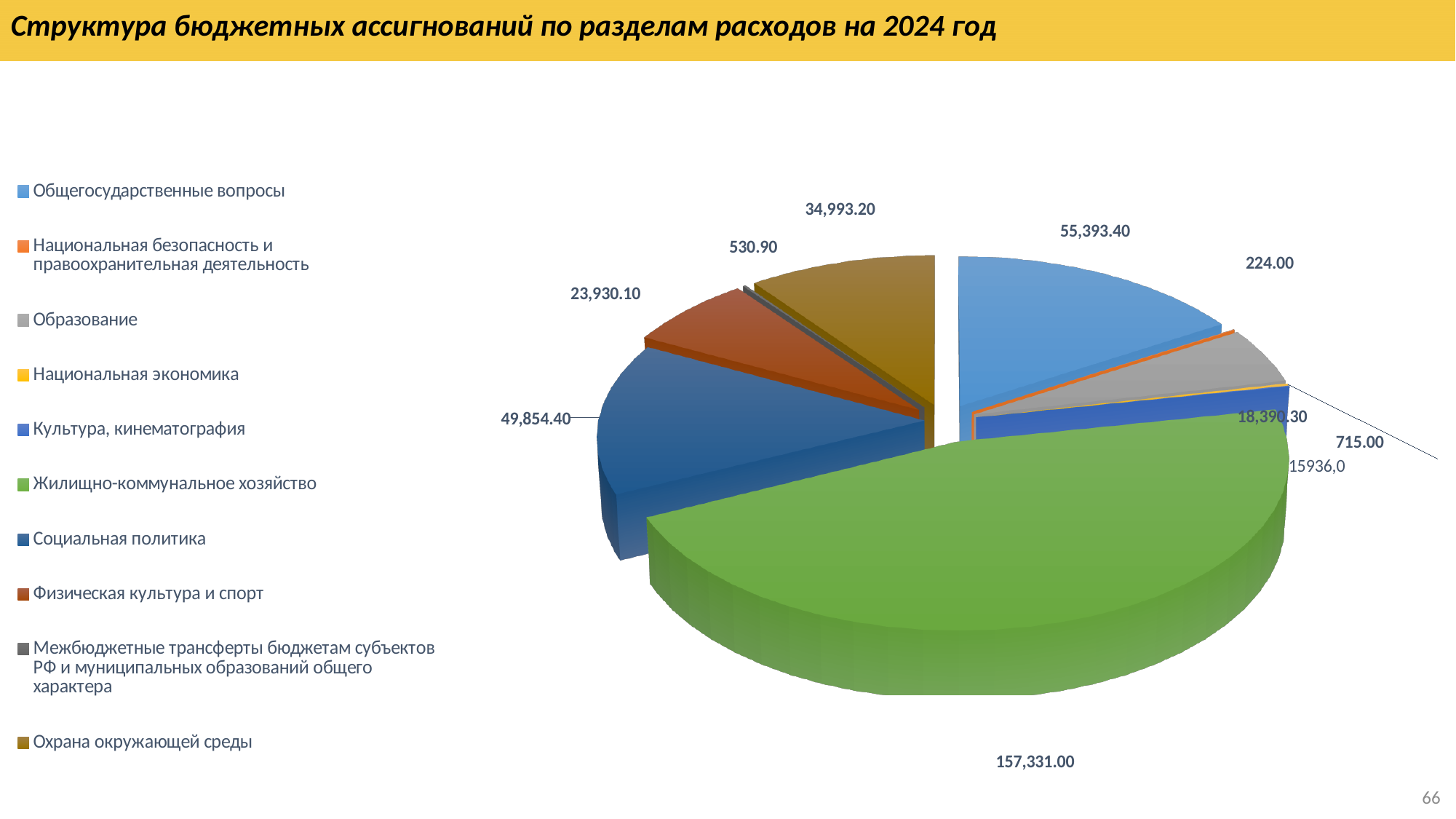
Which category has the smallest value in the pie chart? Национальная безопасность и правоохранительная деятельность What is the value shown for Жилищно-коммунальное хозяйство? 157,331.00 What is the title of the slide? Структура бюджетных ассигнований по разделам расходов на 2024 год What is the difference between the values for Общегосударственные вопросы and Социальная политика? 5,539.00 What is the value shown for Общегосударственные вопросы? 55,393.40 How many categories does the legend of the pie chart list? 10 What is the value shown for Образование? 18,390.30 What is the value shown for Социальная политика? 49,854.40 Which category has the largest slice of the pie chart? Жилищно-коммунальное хозяйство What is the value shown for Физическая культура и спорт? 23,930.10 What is the value shown for Охрана окружающей среды? 34,993.20 What kind of chart is shown on the slide? Pie chart